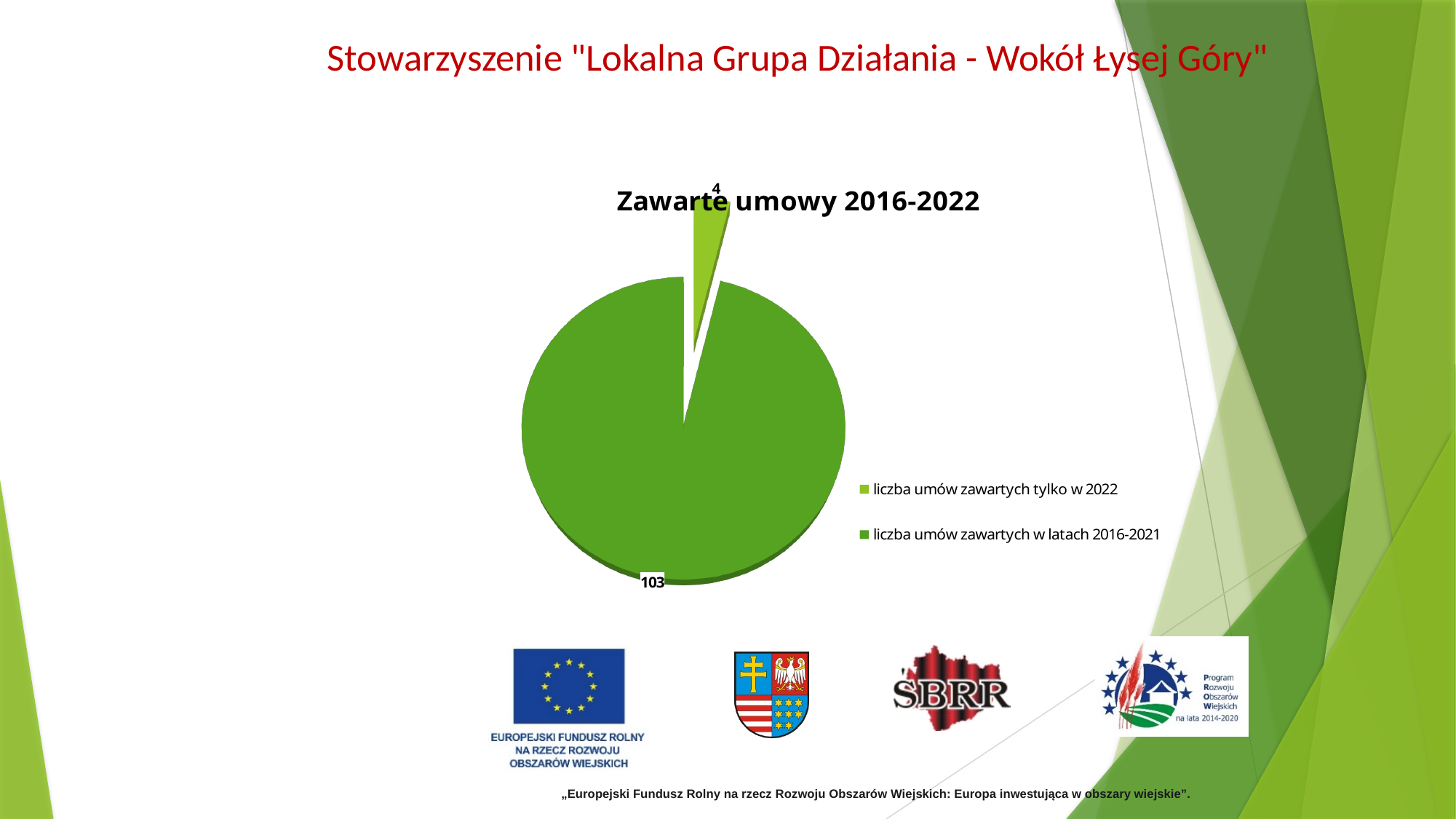
Which category has the largest slice of the pie? liczba umów zawartych w latach 2016-2021 How many slices does the pie chart have? 2 Which category has the smallest slice of the pie? liczba umów zawartych tylko w 2022 What is the total of the two values shown in the pie chart? 107 What type of chart is shown on the slide? pie chart Which legend entry is shown in the lighter green colour? liczba umów zawartych tylko w 2022 How many entries does the legend list? 2 What is the value for 'liczba umów zawartych tylko w 2022'? 4 What is the title of the chart? Zawarte umowy 2016-2022 What is the value for 'liczba umów zawartych w latach 2016-2021'? 103 What is the difference between the number of contracts concluded in 2016-2021 and those concluded only in 2022? 99 Which is larger: the value for 'liczba umów zawartych tylko w 2022' or for 'liczba umów zawartych w latach 2016-2021'? liczba umów zawartych w latach 2016-2021